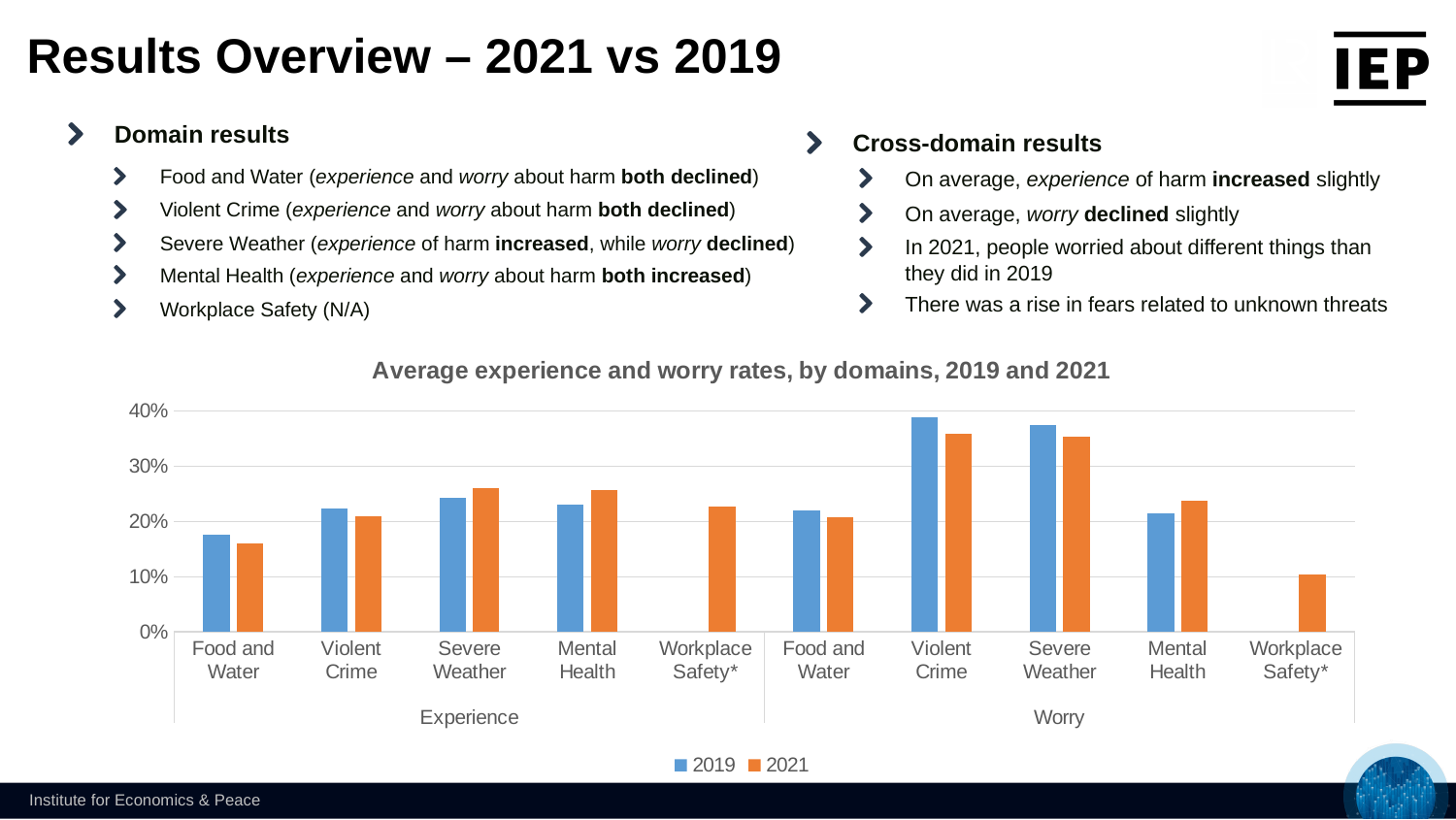
Is the 2021 Worry value for Workplace Safety* greater or less than 20%? less Is the 2021 Experience value for Food and Water greater or less than 20%? less Which bar is the lowest on the chart? Workplace Safety* (Worry), 2021 How many series does the chart legend list? 2 Is the 2019 Worry value for Violent Crime greater or less than 30%? greater What is the title of the chart? Average experience and worry rates, by domains, 2019 and 2021 For Mental Health in the Worry group, which year has the larger value, 2019 or 2021? 2021 What type of chart is shown on the slide? Bar chart How many domain categories are shown in the Experience group? 5 For Severe Weather in the Experience group, which year has the larger value, 2019 or 2021? 2021 Which domain has no 2019 bar in either the Experience or Worry group? Workplace Safety*